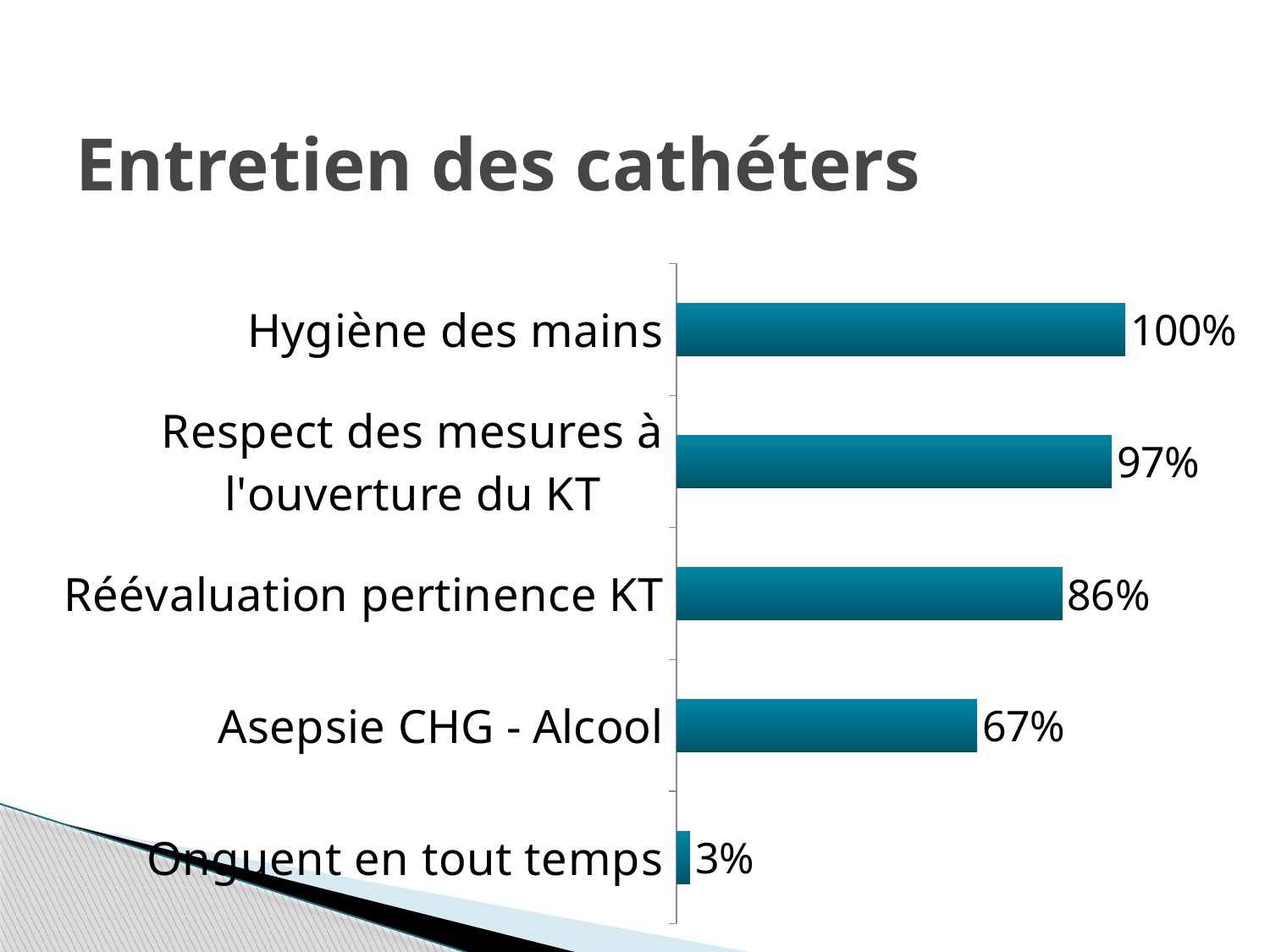
What is the value for Hygiène des mains? 100% Which category has the highest value? Hygiène des mains Which category has the lowest value? Onguent en tout temps How many categories are shown in the chart? 5 What is the difference between the values for Réévaluation pertinence KT and Asepsie CHG - Alcool? 19% What kind of chart is shown on the slide? Bar chart What is the title of the slide? Entretien des cathéters What is the value for Réévaluation pertinence KT? 86% What is the value for Respect des mesures à l'ouverture du KT? 97% What is the value for Onguent en tout temps? 3% Which is larger, the value for Respect des mesures à l'ouverture du KT or the value for Réévaluation pertinence KT? Respect des mesures à l'ouverture du KT What is the value for Asepsie CHG - Alcool? 67%